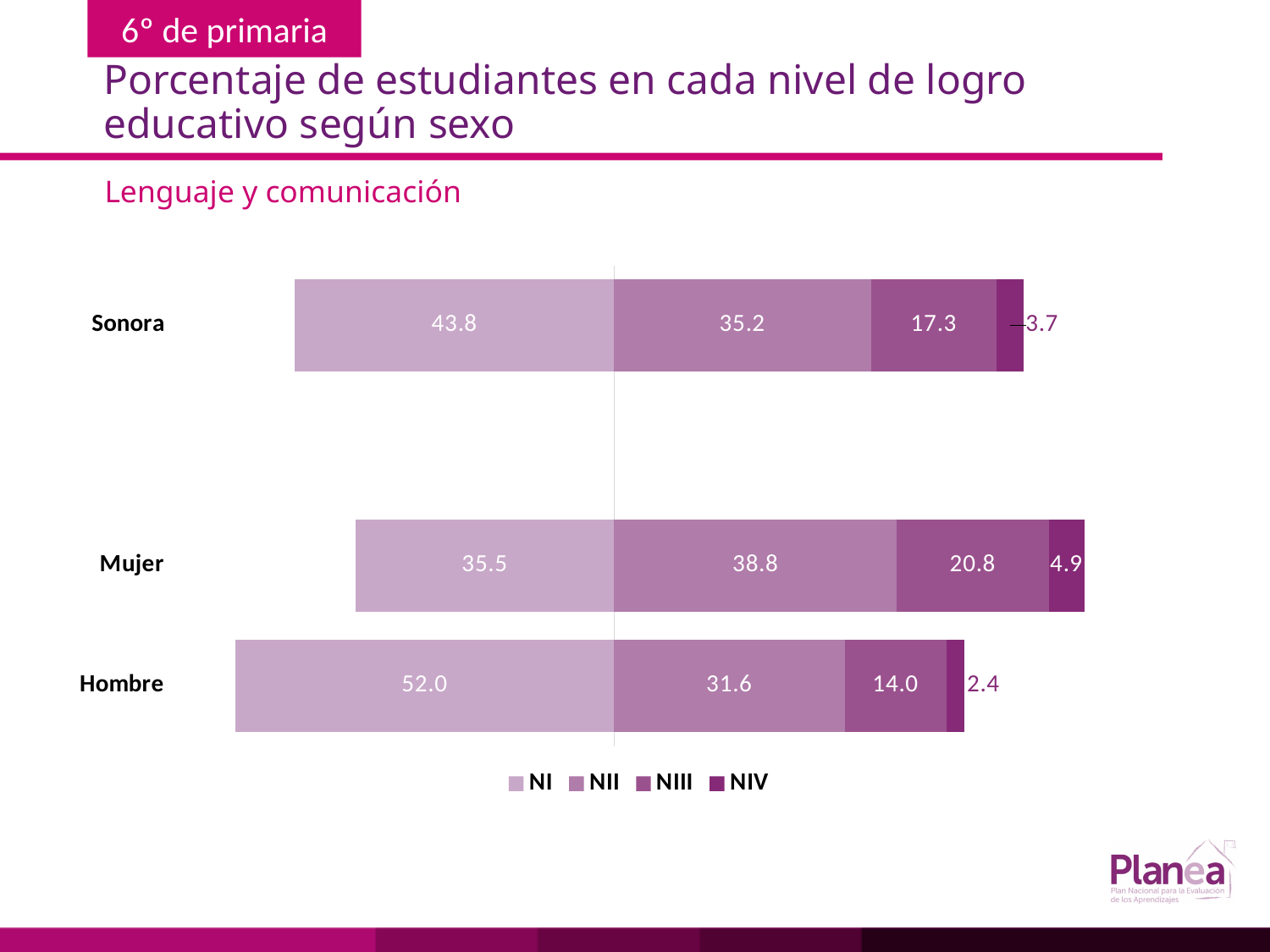
Which is larger, the NIII value for Mujer or for Sonora? Mujer What is the NIII value for Hombre? 14.0 What kind of chart is shown on the slide? Stacked bar chart What is the NI value for Hombre? 52.0 How many series does the legend list? 4 Which category has the highest NI value? Hombre What is the NII value for Mujer? 38.8 What is the NIV value for Sonora? 3.7 What is the difference between the NI values for Hombre and Mujer? 16.5 Which category has the lowest NIV value? Hombre How many categories are shown on the chart? 3 What is the subtitle shown above the chart? Lenguaje y comunicación